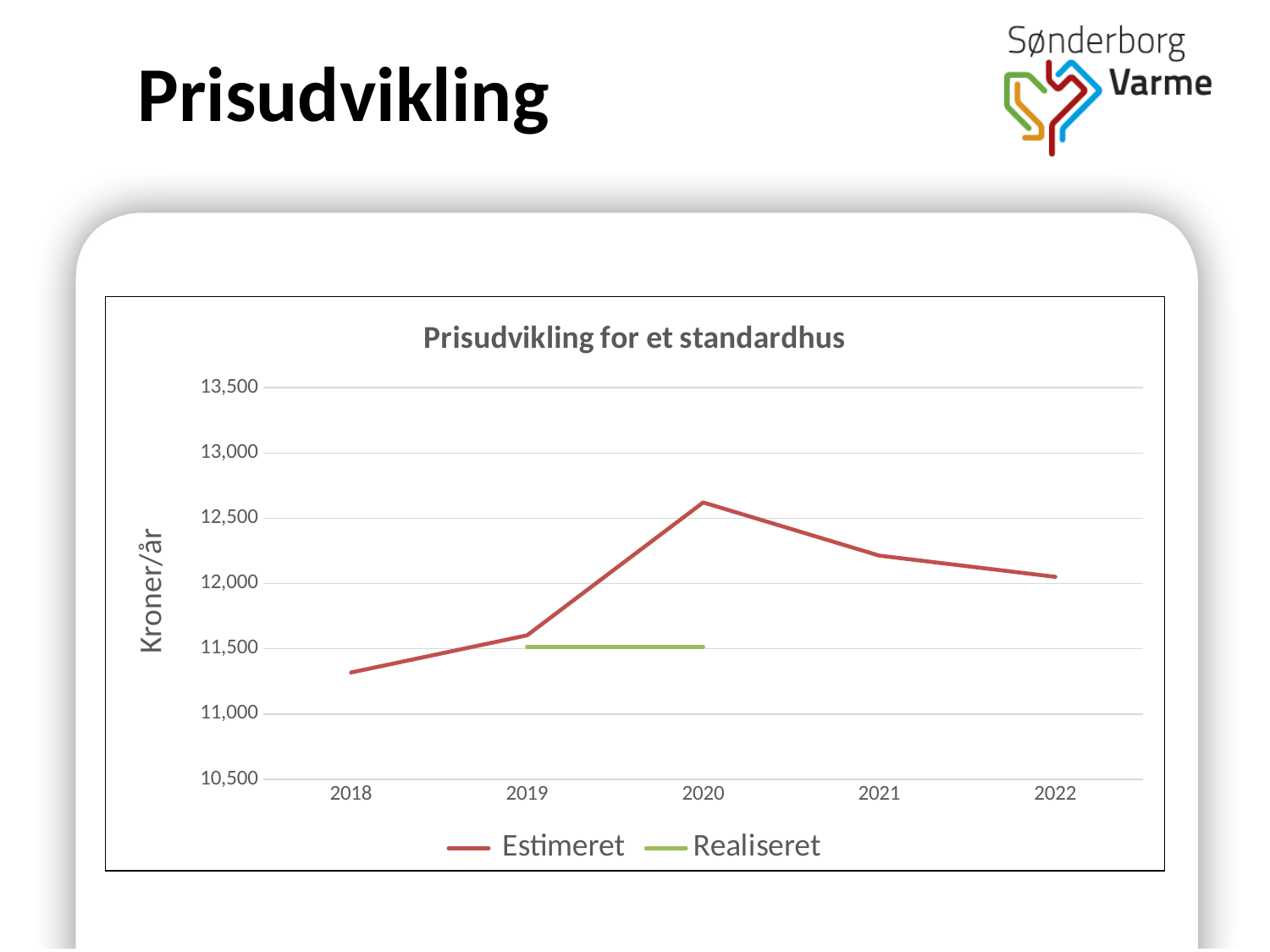
Is the Estimeret value for 2021 greater or less than 12,000? greater Is the Estimeret value for 2020 greater or less than 12,000? greater How many years are shown on the x axis? 5 Does the Estimeret series rise or fall from 2020 to 2022? Fall What is the title of the chart? Prisudvikling for et standardhus What kind of chart is shown on the slide? Line chart In which year does the Estimeret series reach its highest value? 2020 Is the Estimeret value for 2018 greater or less than 11,500? less In which year does the Estimeret series have its lowest value? 2018 How many series does the legend list? 2 In 2020, which series has the larger value, Estimeret or Realiseret? Estimeret